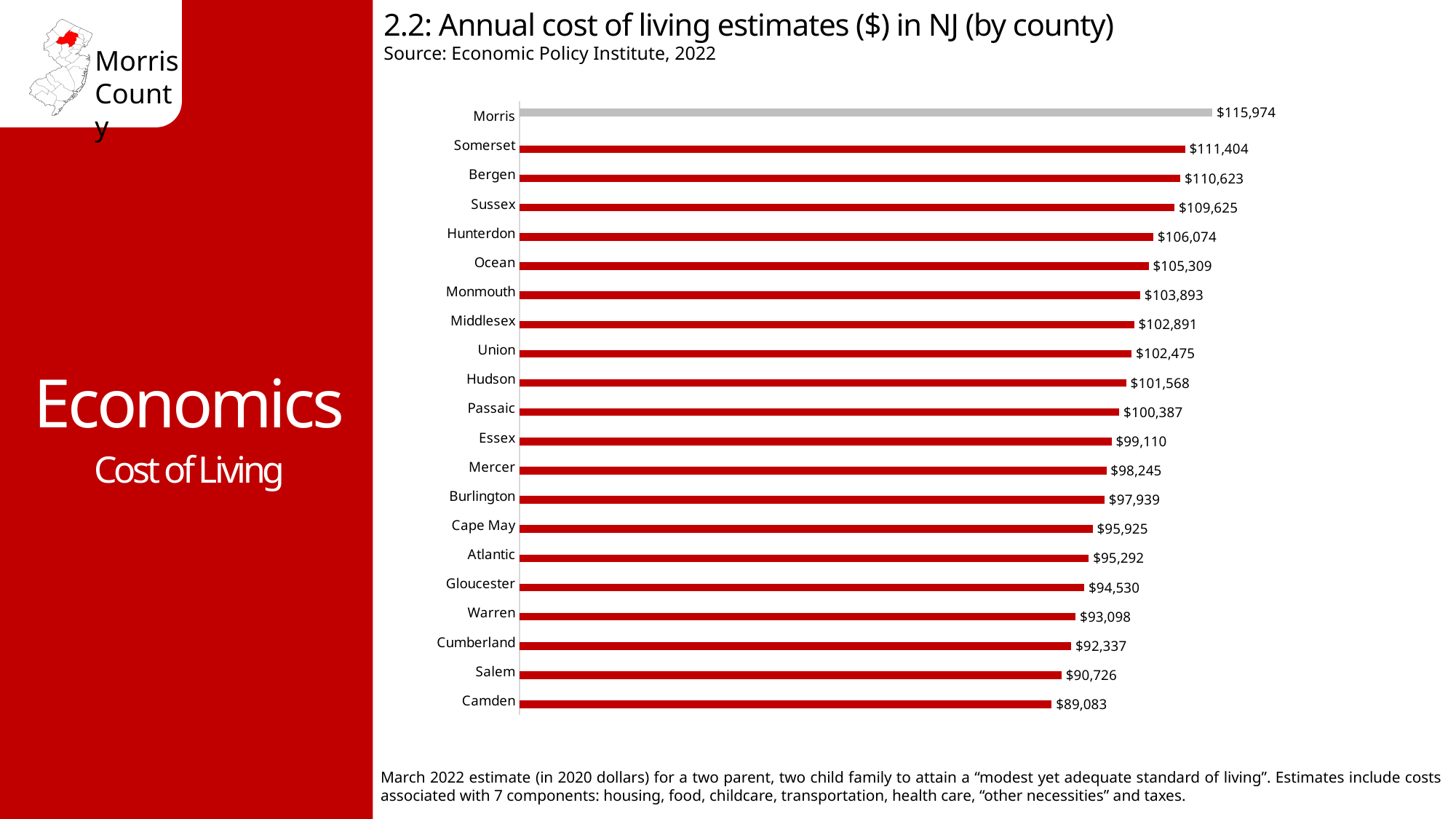
Which county has a higher cost of living estimate, Ocean or Monmouth? Ocean What is the annual cost of living estimate for Cape May County? $95,925 What is the difference between the cost of living estimates for Morris and Somerset counties? $4,570 What is the annual cost of living estimate for Hudson County? $101,568 Which county has the lowest annual cost of living estimate? Camden Which county's bar is shown in a different colour (grey) from the others? Morris Which county has a higher cost of living estimate, Warren or Gloucester? Gloucester What type of chart is used to show the annual cost of living estimates? Bar chart Which county has the highest annual cost of living estimate? Morris How many counties are shown in the chart? 21 What is the difference between the cost of living estimates for Morris and Camden counties? $26,891 What is the annual cost of living estimate for Morris County? $115,974